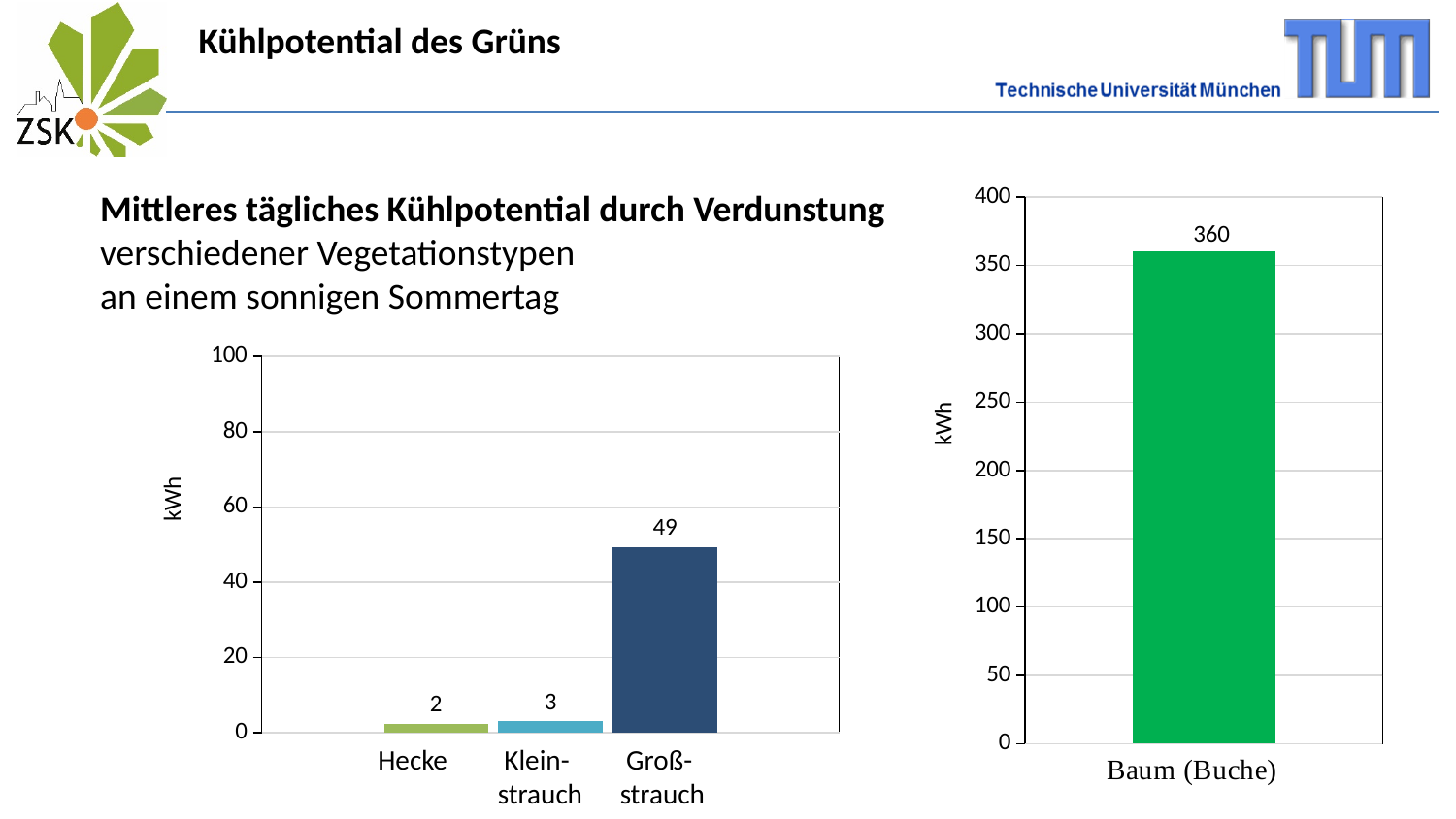
In the left chart, what is the value for Kleinstrauch? 3 In the right chart, is the value for Baum (Buche) greater or less than 350? greater In the left chart, what is the value for Großstrauch? 49 Which is larger: the value for Baum (Buche) in the right chart or the value for Großstrauch in the left chart? Baum (Buche) In the right chart, what is the value for Baum (Buche)? 360 How many categories are shown in the left chart? 3 What kind of chart is the right chart? bar chart In the left chart, what is the difference between the values for Großstrauch and Kleinstrauch? 46 In the left chart, which category has the highest value? Großstrauch In the left chart, what is the value for Hecke? 2 In the left chart, which category has the lowest value? Hecke What unit is shown on the y axis of the left chart? kWh